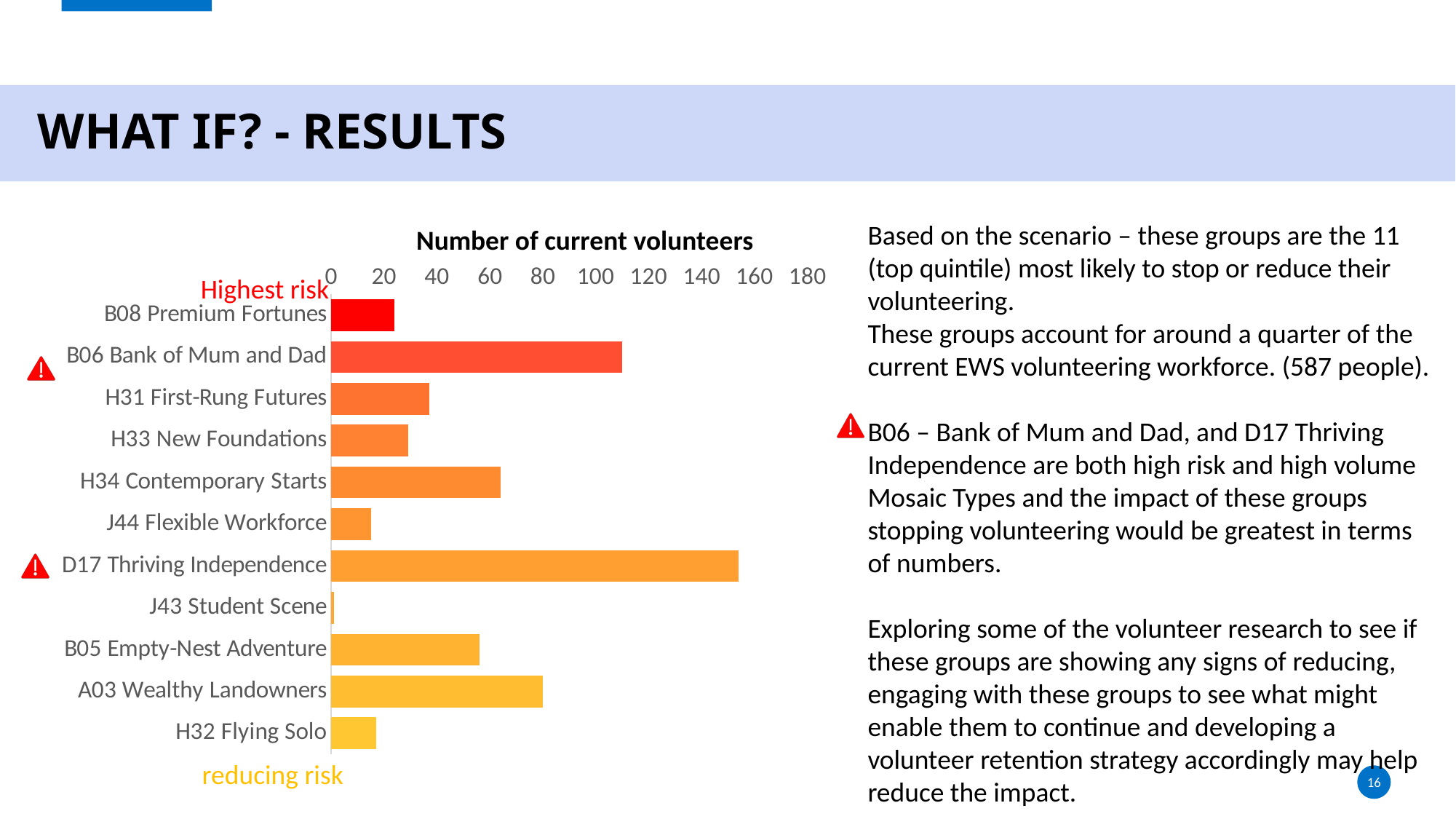
Is the value for A03 Wealthy Landowners greater or less than 60? greater Which has more current volunteers, A03 Wealthy Landowners or B05 Empty-Nest Adventure? A03 Wealthy Landowners Which group has the highest number of current volunteers? D17 Thriving Independence Which has more current volunteers, B06 Bank of Mum and Dad or H34 Contemporary Starts? B06 Bank of Mum and Dad What type of chart is shown on the slide? Bar chart Is the value for B06 Bank of Mum and Dad greater or less than 100? greater Which group is positioned at the 'Highest risk' end of the chart? B08 Premium Fortunes Which group has the lowest number of current volunteers? J43 Student Scene Is the value for D17 Thriving Independence greater or less than 140? greater How many groups (categories) are plotted in the chart? 11 What is the title of the chart? Number of current volunteers